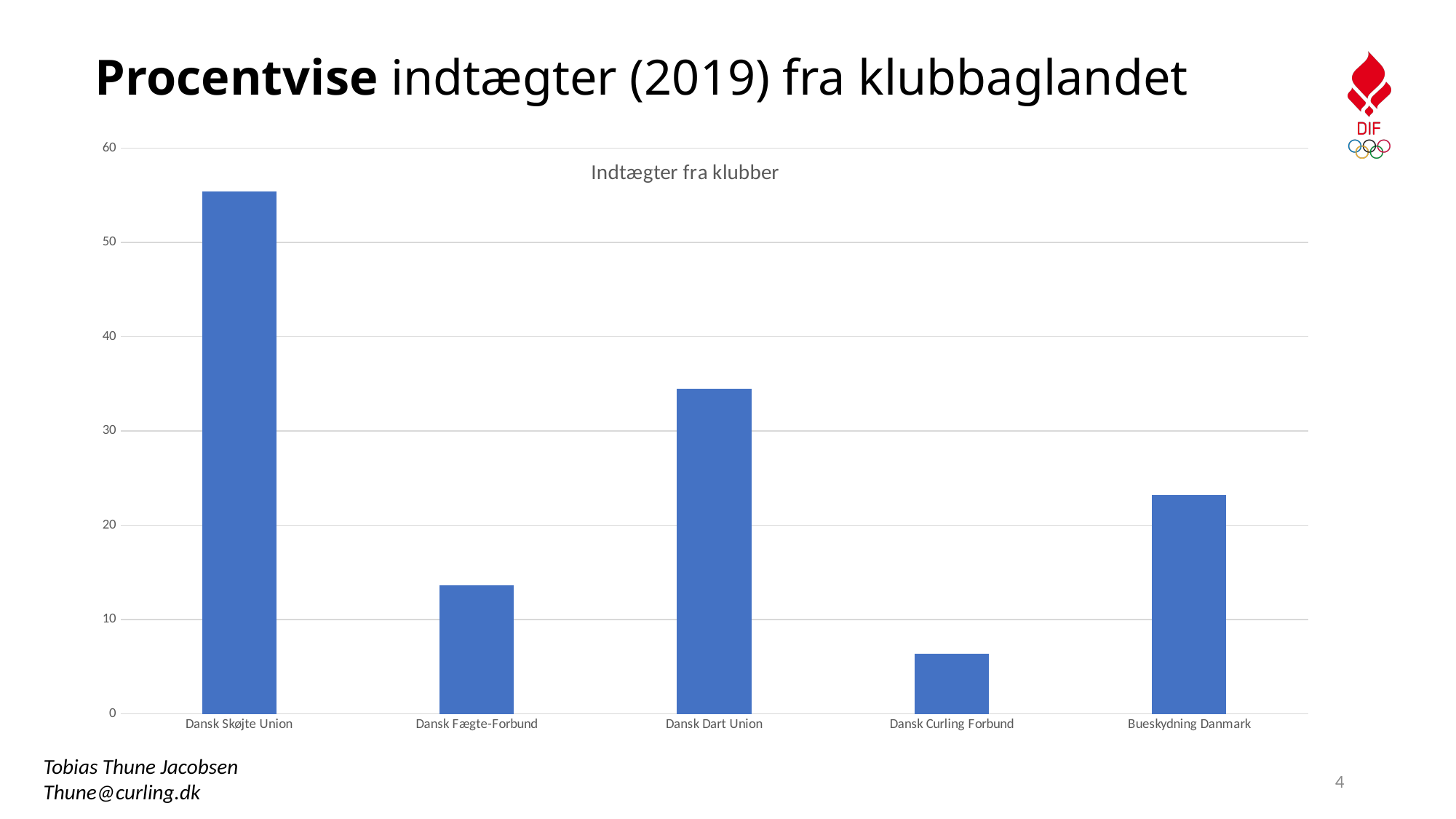
Is the value for Dansk Fægte-Forbund greater or less than 20? less Is the value for Dansk Dart Union greater or less than 30? greater Is the value for Dansk Curling Forbund greater or less than 10? less Which is larger, the value for Dansk Dart Union or the value for Bueskydning Danmark? Dansk Dart Union What is the title of the chart? Indtægter fra klubber How many categories are shown on the x axis of the chart? 5 Which category has the highest value in the chart? Dansk Skøjte Union Which is larger, the value for Dansk Fægte-Forbund or the value for Dansk Curling Forbund? Dansk Fægte-Forbund What kind of chart is shown on the slide? bar chart Which category has the lowest value in the chart? Dansk Curling Forbund